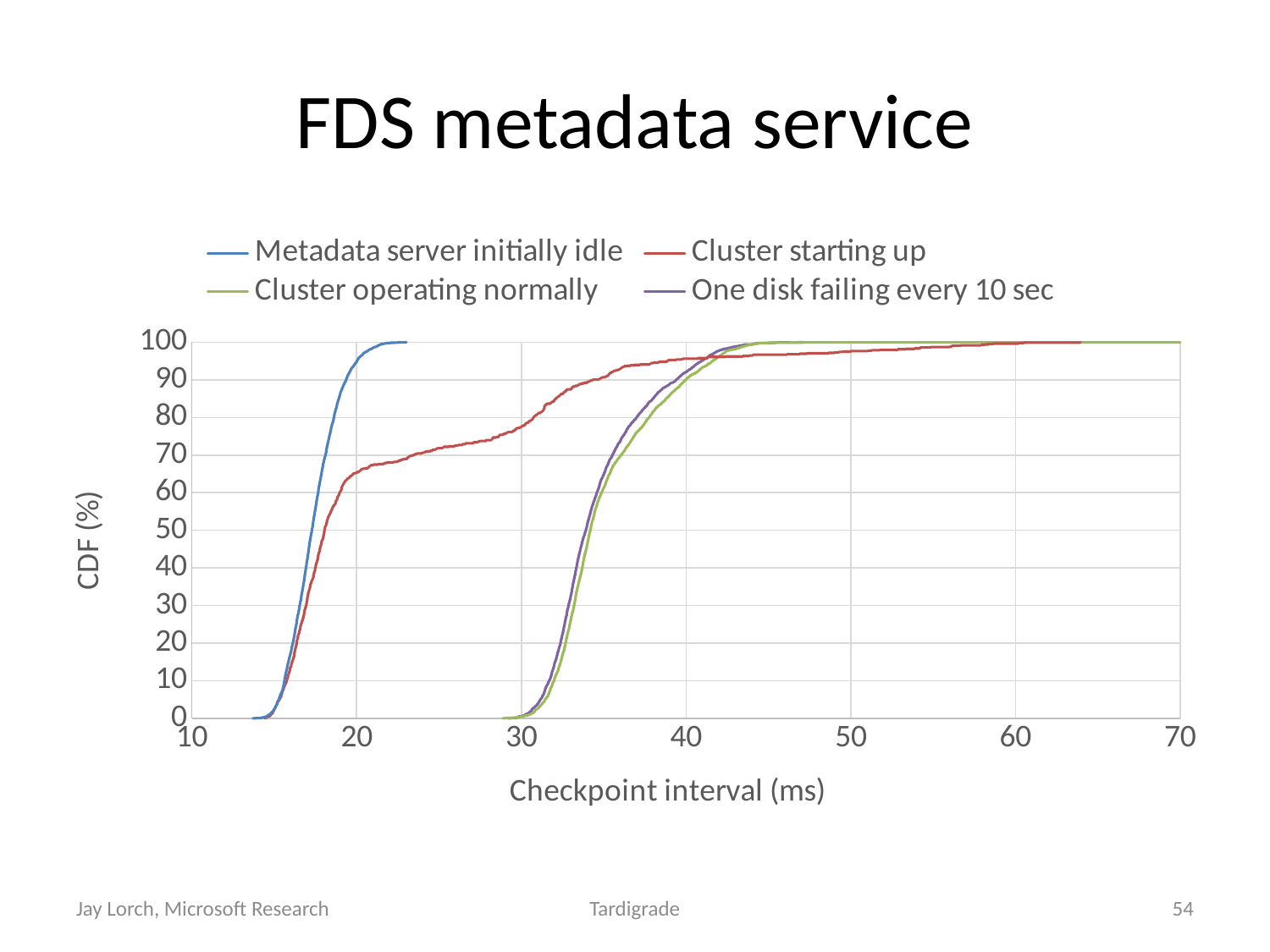
Is the value for 'Cluster starting up' at a checkpoint interval of 30 ms greater or less than 70? greater What is the label of the y axis? CDF (%) How many series does the legend list? 4 At a checkpoint interval of 20 ms, which series has the higher CDF value: 'Metadata server initially idle' or 'Cluster starting up'? Metadata server initially idle At a checkpoint interval of 35 ms, which series has the higher CDF value: 'Cluster starting up' or 'Cluster operating normally'? Cluster starting up Is the value for 'Metadata server initially idle' at a checkpoint interval of 20 ms greater or less than 90? greater What kind of chart is shown on the slide? line chart Is the value for 'Cluster operating normally' at a checkpoint interval of 30 ms greater or less than 10? less Do the CDF values rise or fall as the checkpoint interval increases along the x axis? rise What is the label of the x axis? Checkpoint interval (ms)